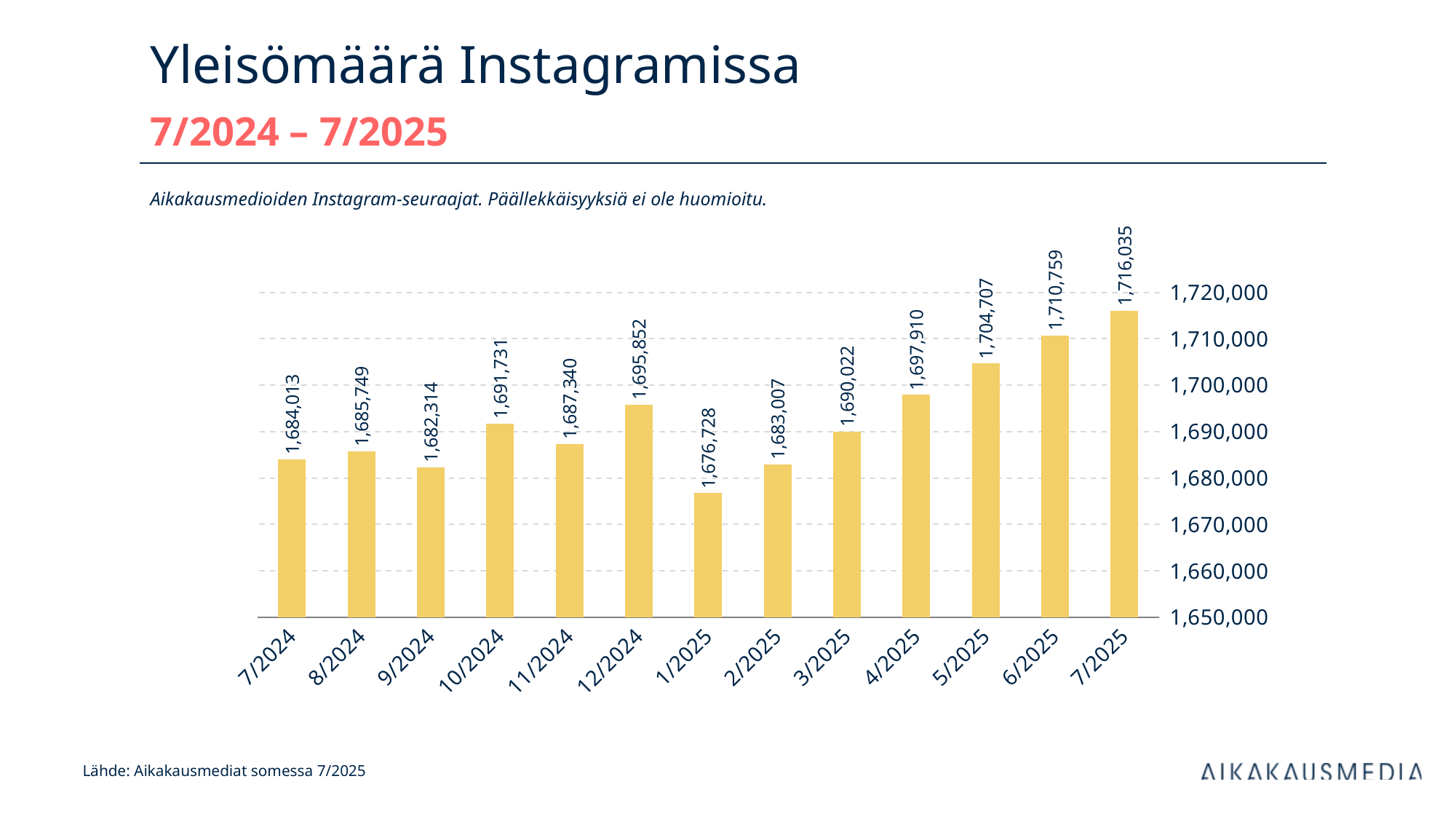
Is the value for 1/2025 greater or less than 1,680,000? less Which is larger, the value for 10/2024 or the value for 11/2024? 10/2024 Which month has the lowest value? 1/2025 Do the values rise or fall from 1/2025 to 7/2025? rise What is the value for 12/2024? 1,695,852 How many months are shown on the x axis? 13 Which month has the highest value? 7/2025 What is the difference between the values for 7/2025 and 7/2024? 32,022 What is the difference between the values for 6/2025 and 5/2025? 6,052 What kind of chart is shown on the slide? bar chart What is the value for 7/2025? 1,716,035 What is the value for 1/2025? 1,676,728